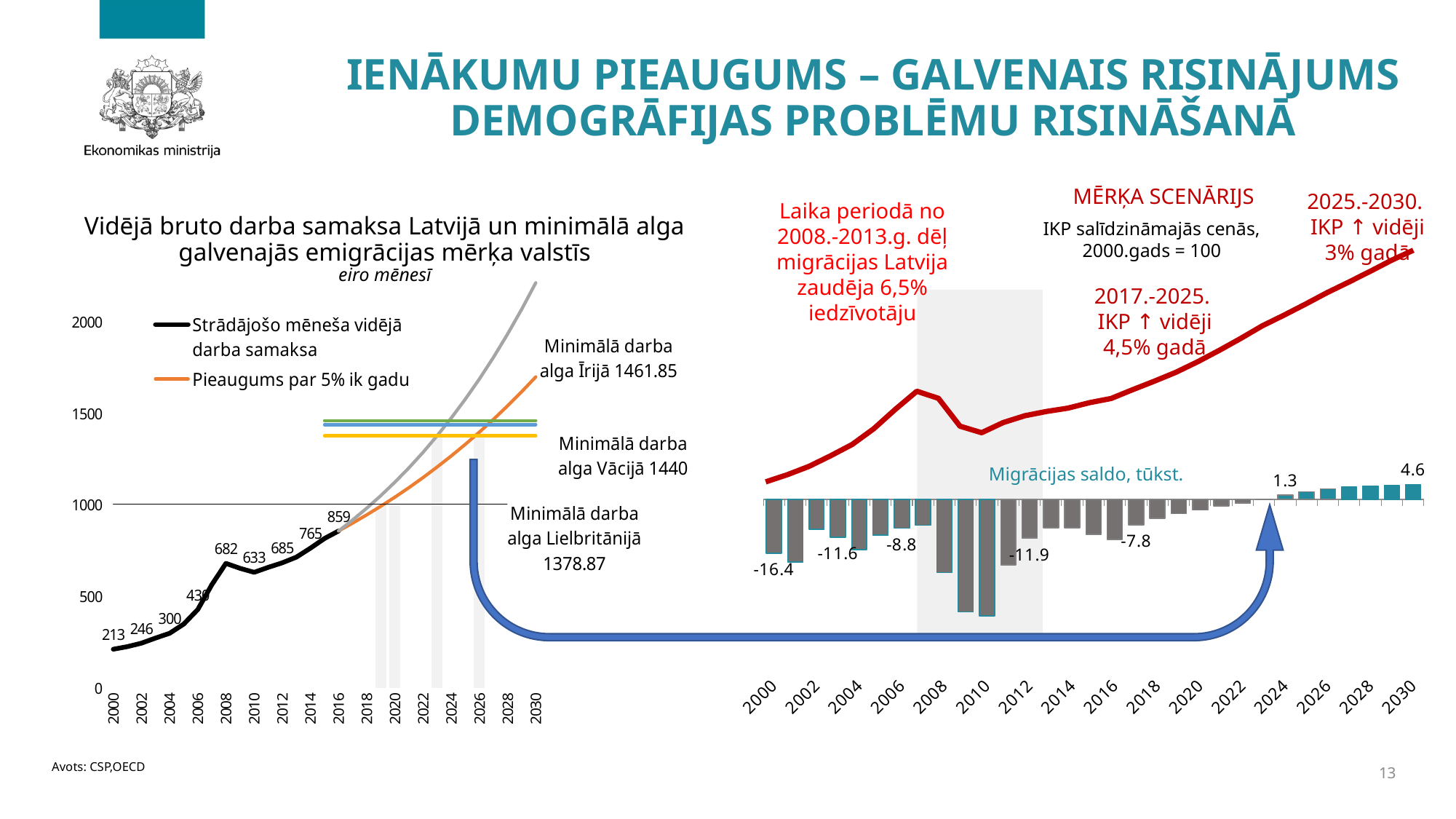
In the left chart (Vidējā bruto darba samaksa Latvijā), what is the value of the average monthly wage in 2008? 682 In the left chart (Vidējā bruto darba samaksa Latvijā), does the average monthly wage rise or fall from 2000 to 2016? rise In the right chart, what is the migration balance (Migrācijas saldo, tūkst.) in 2030? 4.6 In the left chart (Vidējā bruto darba samaksa Latvijā), what is the minimum wage in Germany (Minimālā darba alga Vācijā)? 1440 In the right chart, what kind of chart is used to show the migration balance (Migrācijas saldo, tūkst.)? bar chart In the left chart (Vidējā bruto darba samaksa Latvijā), how many series does the legend list? 2 In the left chart (Vidējā bruto darba samaksa Latvijā), by how much did the average monthly wage increase between 2000 and 2016? 646 In the right chart, what is the migration balance (Migrācijas saldo, tūkst.) in 2000? -16.4 In the left chart (Vidējā bruto darba samaksa Latvijā), what is the value of the average monthly wage in 2016? 859 In the left chart (Vidējā bruto darba samaksa Latvijā), what is the value of the average monthly wage in 2000? 213 In the left chart (Vidējā bruto darba samaksa Latvijā), which year has the higher average wage, 2008 or 2010? 2008 In the left chart (Vidējā bruto darba samaksa Latvijā), what is the minimum wage in Ireland (Minimālā darba alga Īrijā)? 1461.85